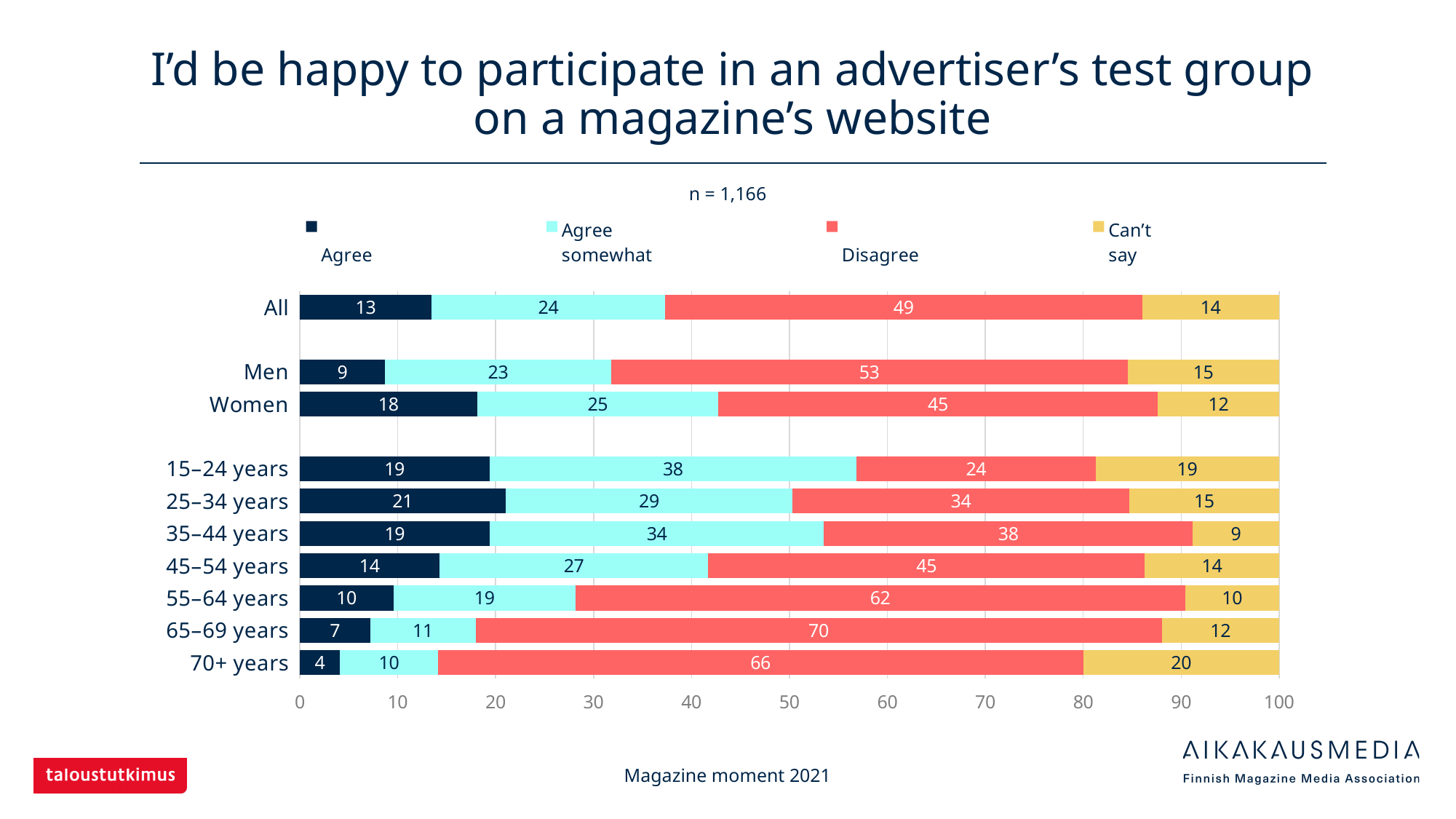
Which category has the lowest Agree value? 70+ years What is the Agree value for Women? 18 How many categories are plotted on the chart? 10 What is the Can't say value for the 70+ years group? 20 Which is larger, the Agree somewhat value for 25–34 years or for 35–44 years? 35–44 years What is the difference between the Disagree values for Men and Women? 8 What kind of chart is shown on the slide? Stacked bar chart What is the sample size shown above the chart? n = 1,166 How many series does the legend list? 4 What is the Agree somewhat value for the 15–24 years group? 38 What is the Disagree value for the 65–69 years group? 70 Which category has the highest Disagree value? 65–69 years